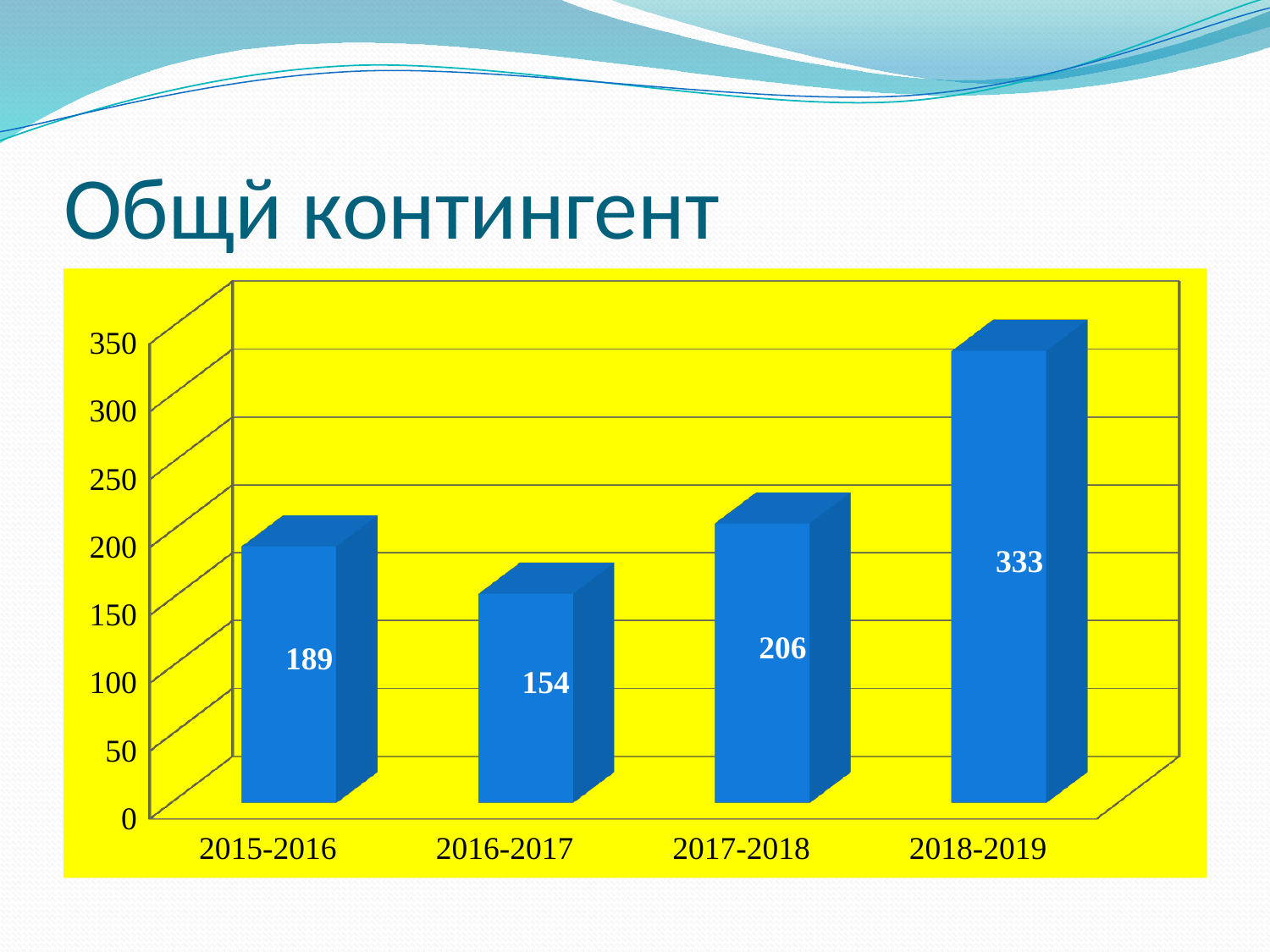
Is the value for 2018-2019 greater or less than 300? greater Which is larger, the value for 2015-2016 or the value for 2017-2018? 2017-2018 What is the value for 2017-2018? 206 What is the value for 2015-2016? 189 How many periods are shown on the x axis? 4 What is the difference between the values for 2015-2016 and 2016-2017? 35 What kind of chart is shown on the slide? bar chart Which period has the highest value? 2018-2019 What is the value for 2016-2017? 154 What is the difference between the values for 2018-2019 and 2017-2018? 127 What is the value for 2018-2019? 333 Which period has the lowest value? 2016-2017